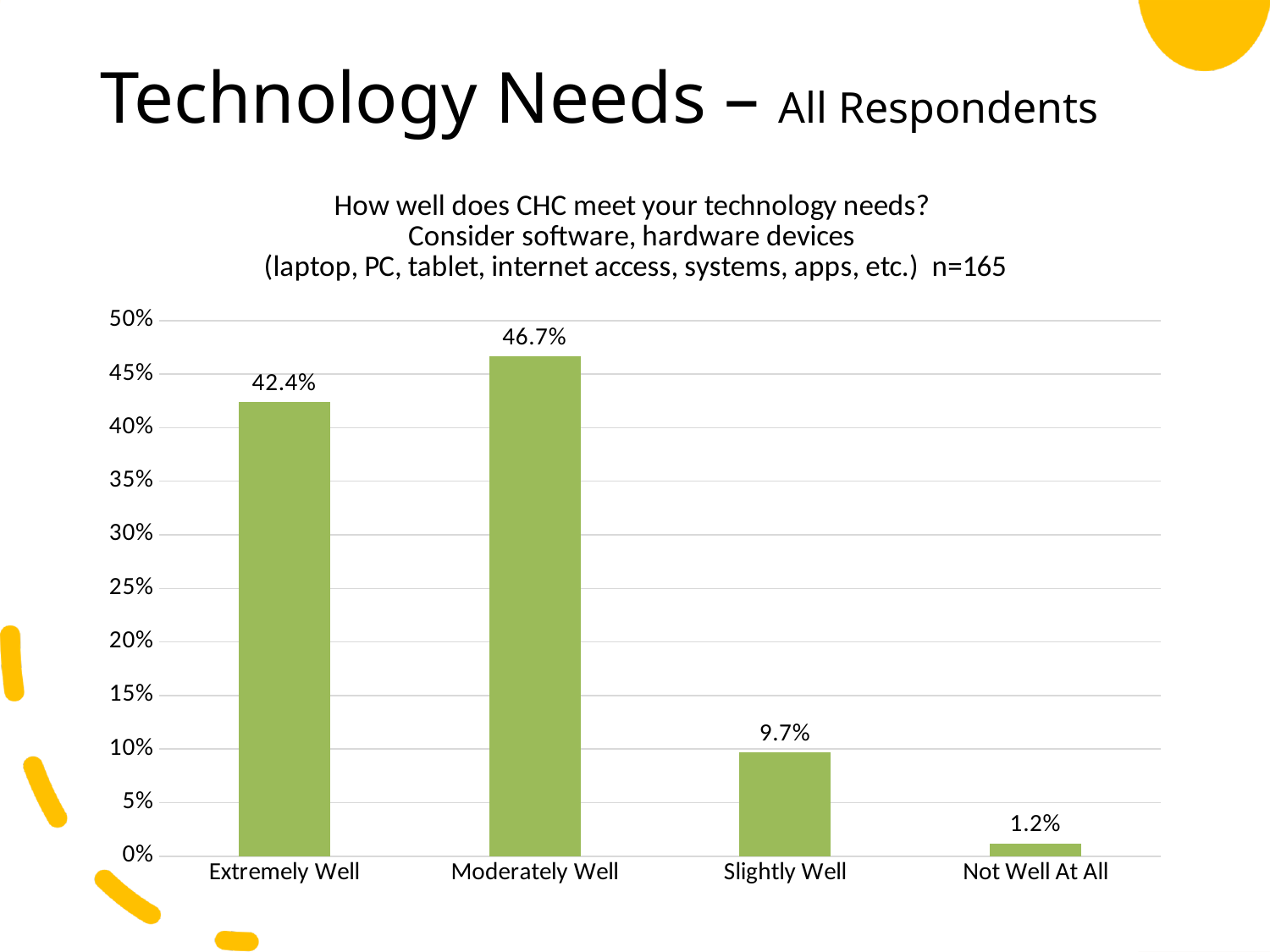
What is the difference between the Moderately Well and Extremely Well values? 4.3% Which category has the lowest value? Not Well At All What percentage of respondents said CHC meets their technology needs Extremely Well? 42.4% What is the value for Not Well At All? 1.2% Is the value for Extremely Well greater or less than 40%? greater What is the sample size (n) stated in the chart title? 165 What is the value for Slightly Well? 9.7% What is the value for Moderately Well? 46.7% How many categories are shown on the x axis? 4 Which is larger, the value for Slightly Well or the value for Not Well At All? Slightly Well What kind of chart is shown on the slide? Bar chart Which category has the highest value? Moderately Well